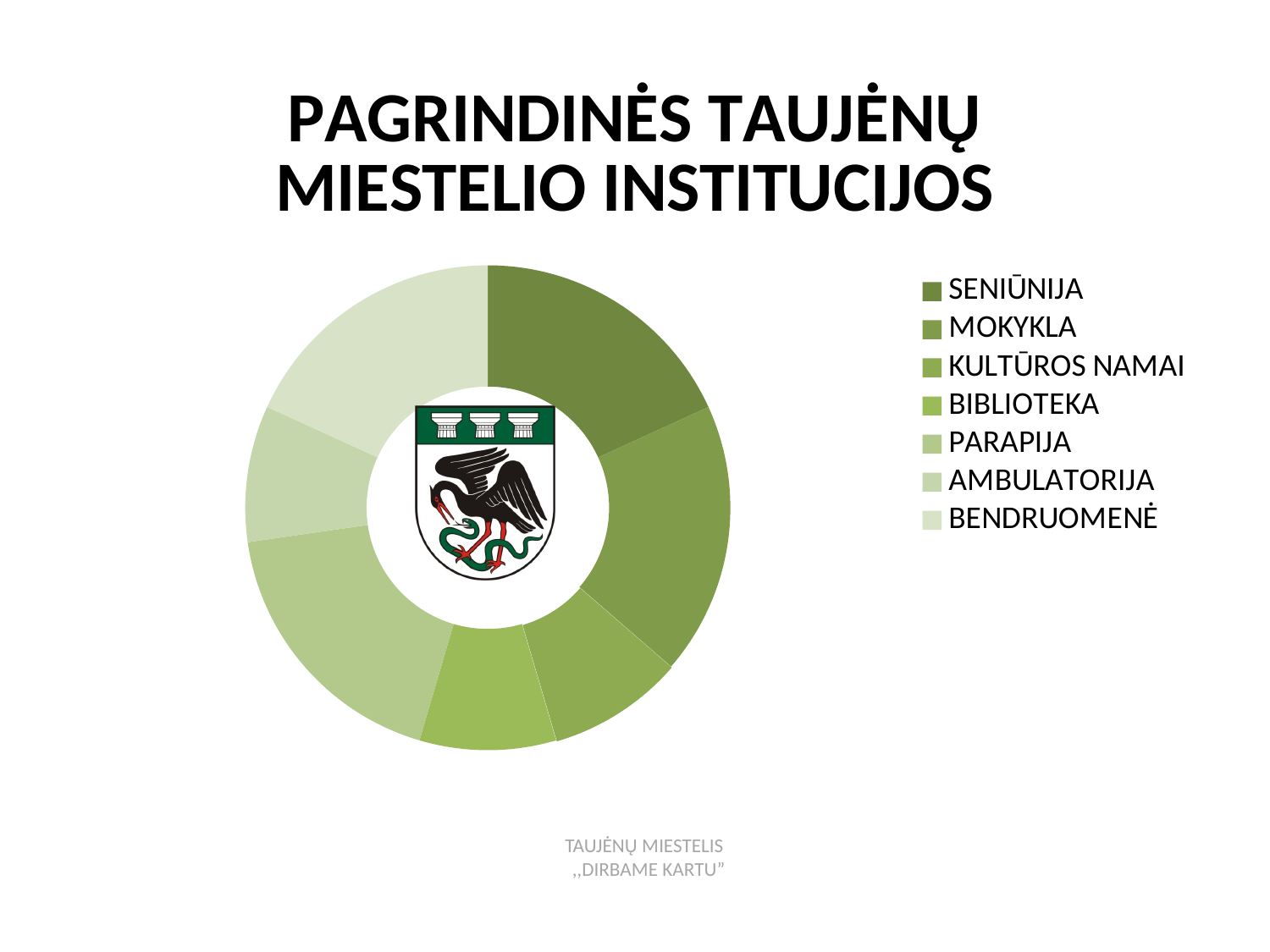
Which legend entry is listed last? BENDRUOMENĖ Which slice is larger, SENIŪNIJA or KULTŪROS NAMAI? SENIŪNIJA What kind of chart is shown on the slide? Doughnut (pie) chart Which slice is larger, BENDRUOMENĖ or AMBULATORIJA? BENDRUOMENĖ How many categories does the chart show? 7 Which slice is larger, PARAPIJA or BIBLIOTEKA? PARAPIJA How many entries does the legend list? 7 What is the title of the slide containing the chart? PAGRINDINĖS TAUJĖNŲ MIESTELIO INSTITUCIJOS